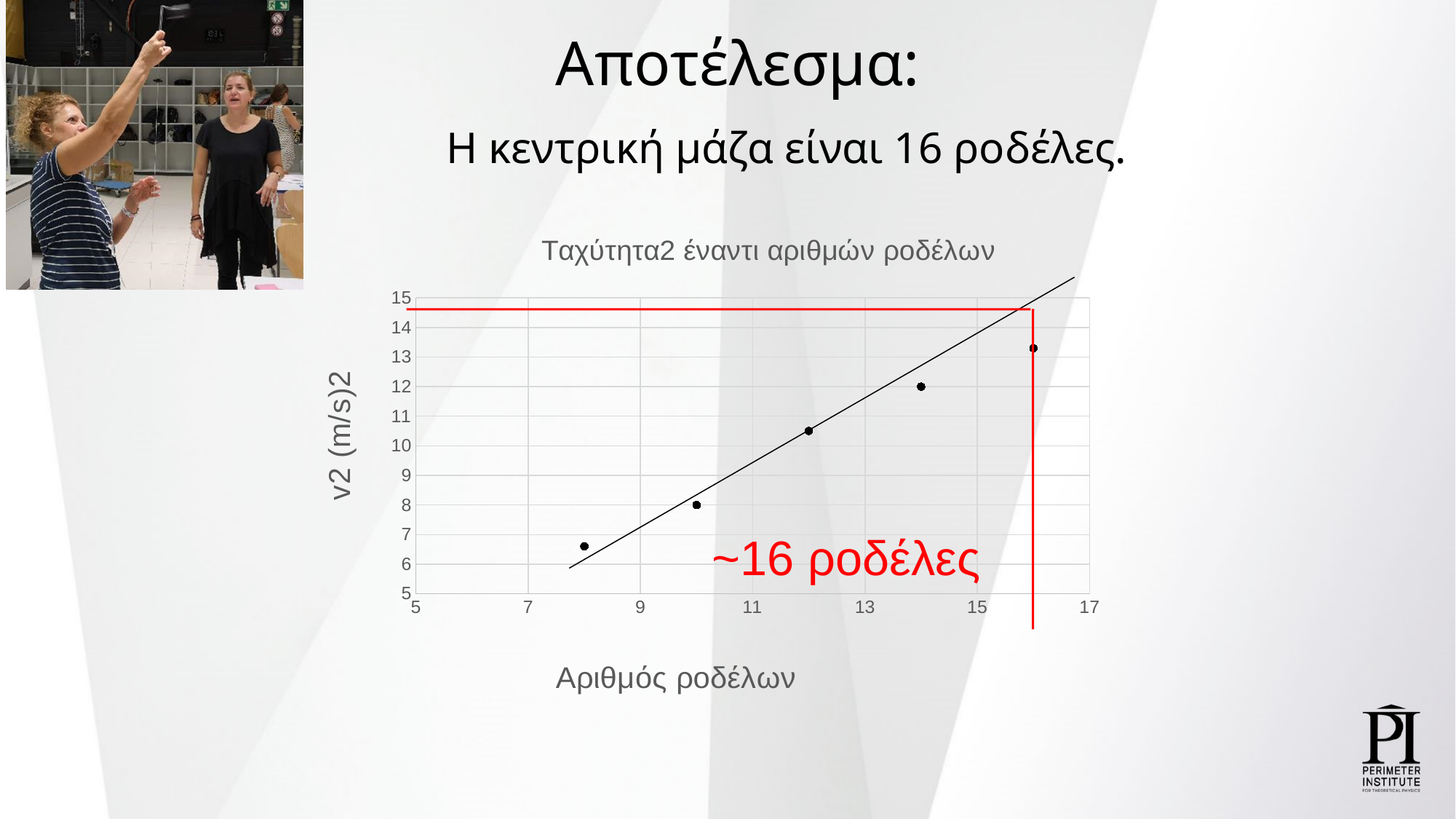
What is the label of the x axis? Αριθμός ροδέλων Which has the larger v2 value: 12 washers or 14 washers? 14 washers What kind of chart is shown on the slide? scatter chart At which number of washers is the plotted v2 value highest? 16 Do the plotted values rise or fall as the number of washers increases along the x axis? rise Is the v2 value for 10 washers greater or less than 9? less How many data points are plotted on the chart? 5 Is the v2 value for 12 washers greater or less than 10? greater Is the v2 value for 16 washers greater or less than 12? greater What is the title of the chart? Ταχύτητα2 έναντι αριθμών ροδέλων At which number of washers is the plotted v2 value lowest? 8